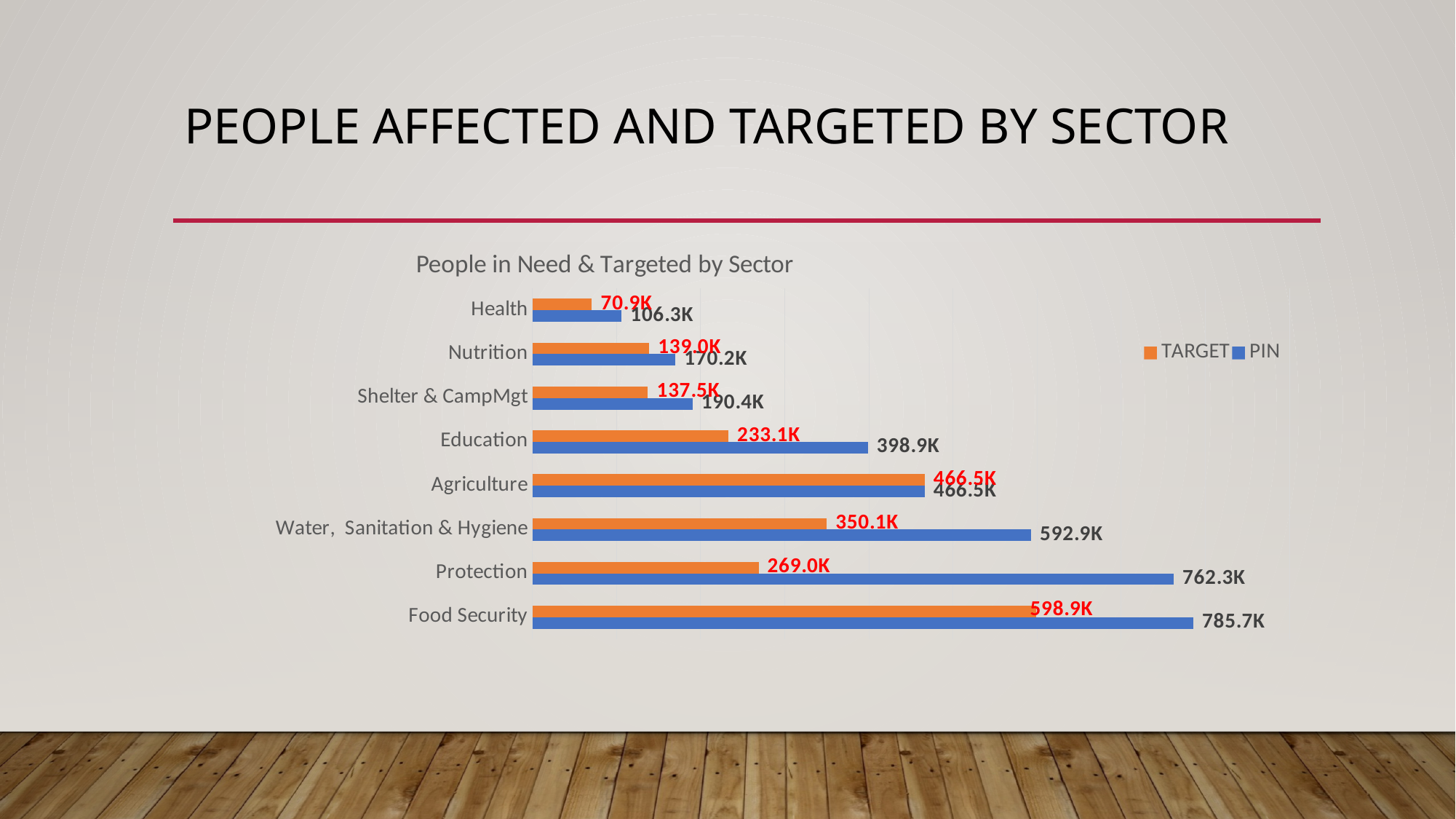
What is the PIN value for Water, Sanitation & Hygiene? 592.9K Which sector has the lowest TARGET value? Health What is the PIN value for Food Security? 785.7K How many series does the legend list? 2 What is the TARGET value for Shelter & CampMgt? 137.5K Which sector has the highest PIN value? Food Security What is the TARGET value for Protection? 269.0K What is the difference between the PIN and TARGET values for Protection? 493.3K What type of chart is shown on the slide? Bar chart How many sectors are shown in the chart? 8 Which is larger, the TARGET value for Nutrition or the TARGET value for Shelter & CampMgt? Nutrition What is the difference between the PIN and TARGET values for Food Security? 186.8K